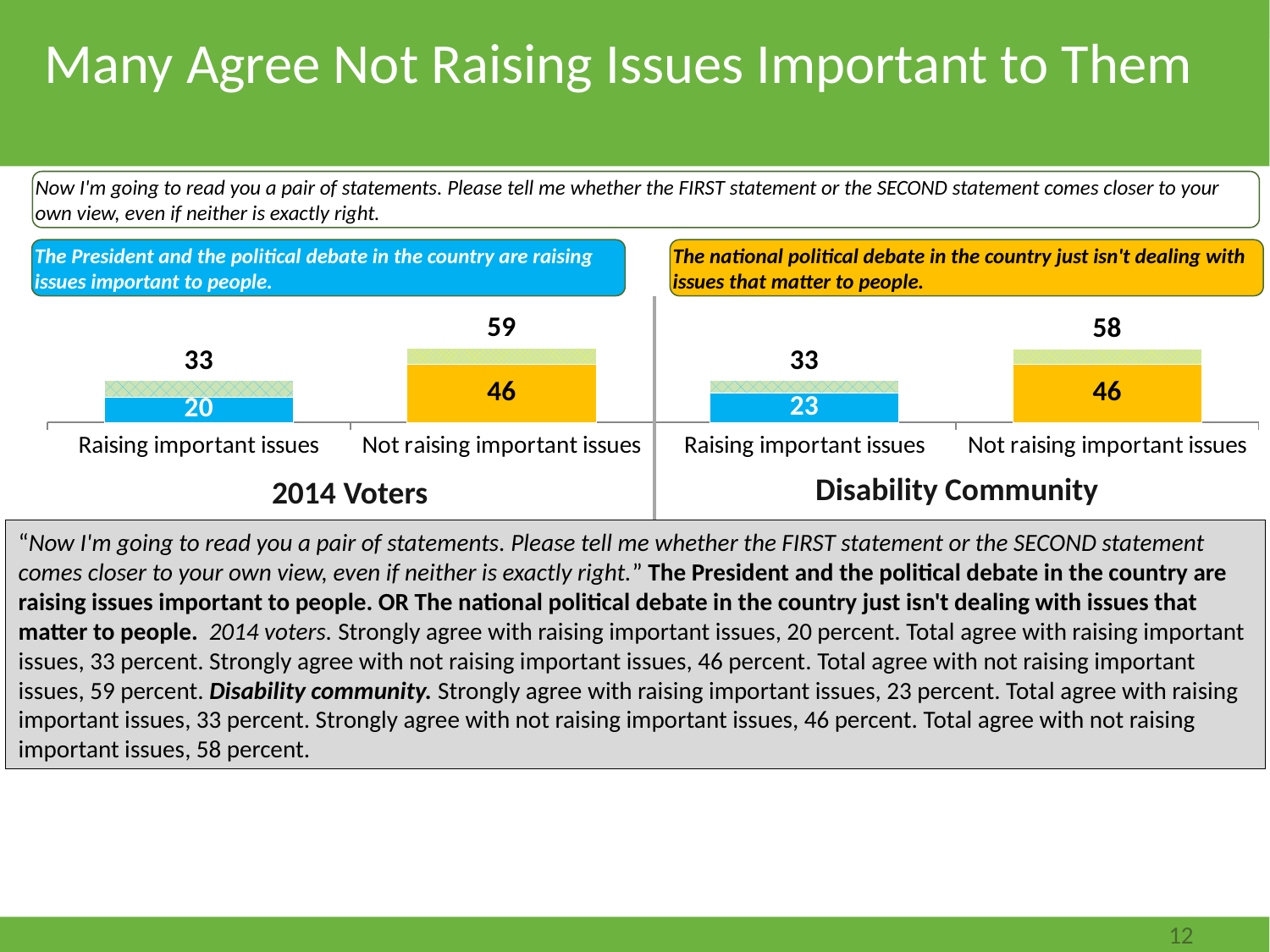
In the 2014 Voters chart, what is the strongly agree value for Raising important issues? 20 Is the total for Not raising important issues larger in the 2014 Voters chart or the Disability Community chart? 2014 Voters In the 2014 Voters chart, what is the total agree value for Not raising important issues? 59 In the Disability Community chart, what is the strongly agree value for Raising important issues? 23 In the Disability Community chart, what is the total agree value for Not raising important issues? 58 How many charts are shown on the slide? 2 How many categories are shown in the 2014 Voters chart? 2 In the 2014 Voters chart, which category has the higher total? Not raising important issues In the Disability Community chart, which category has the lower total? Raising important issues In the Disability Community chart, what is the difference between the totals for Not raising important issues and Raising important issues? 25 In the 2014 Voters chart, what is the difference between the totals for Not raising important issues and Raising important issues? 26 What kind of chart is the Disability Community chart? Bar chart